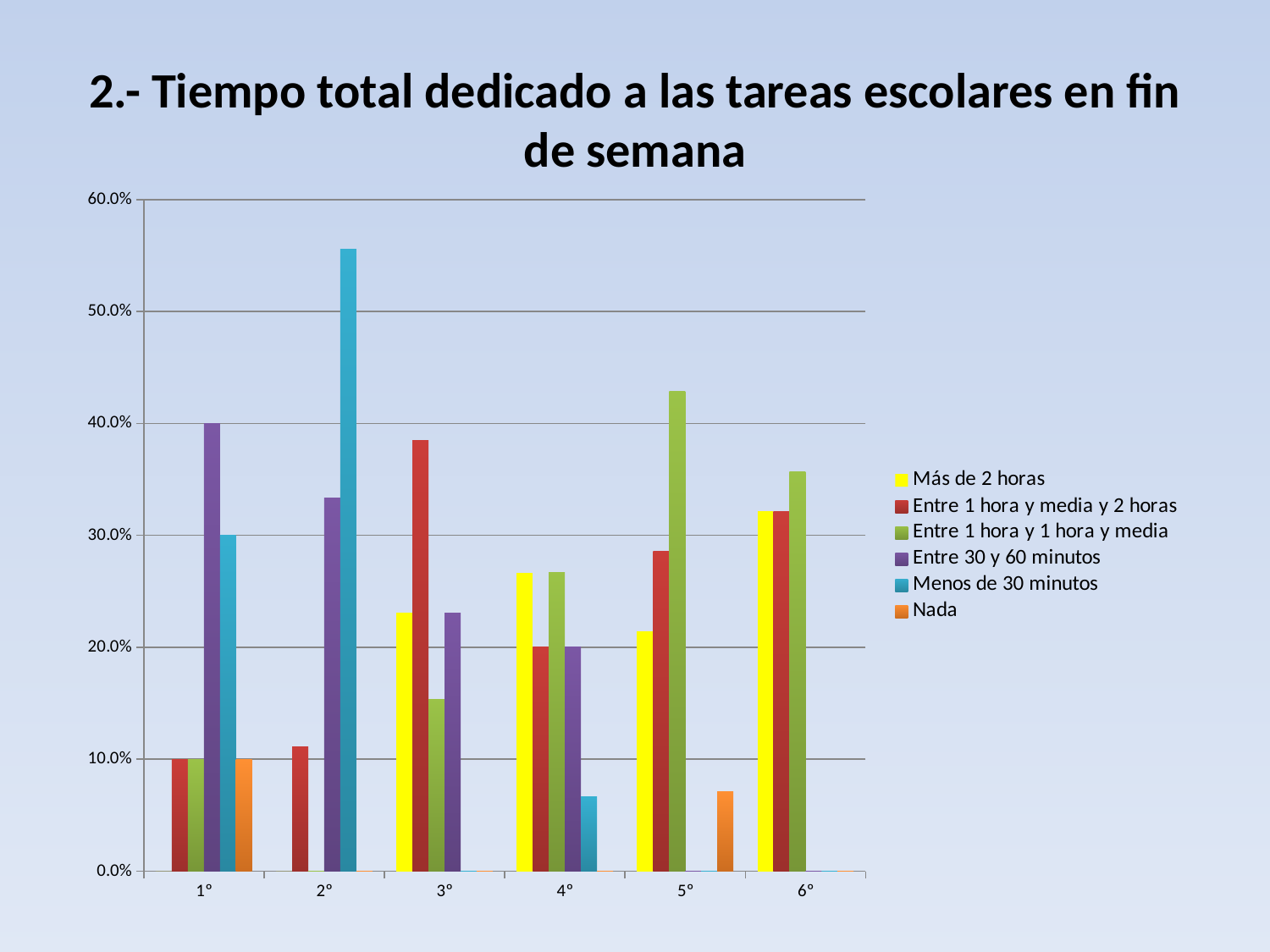
Is the value for 'Nada' in 5° greater or less than 10%? less Which is larger in 1°: 'Entre 30 y 60 minutos' or 'Menos de 30 minutos'? Entre 30 y 60 minutos Which category has the highest value for 'Entre 1 hora y 1 hora y media'? 5° Which series is shown in yellow in the legend? Más de 2 horas How many series does the legend list? 6 What is the title of the chart? 2.- Tiempo total dedicado a las tareas escolares en fin de semana Is the value for 'Menos de 30 minutos' in 2° greater or less than 50%? greater How many categories are shown on the x axis? 6 Is the value for 'Entre 1 hora y media y 2 horas' in 3° greater or less than 30%? greater Which is larger in 3°: 'Más de 2 horas' or 'Entre 1 hora y 1 hora y media'? Más de 2 horas Which category has the highest value for 'Menos de 30 minutos'? 2° What kind of chart is shown on the slide? bar chart